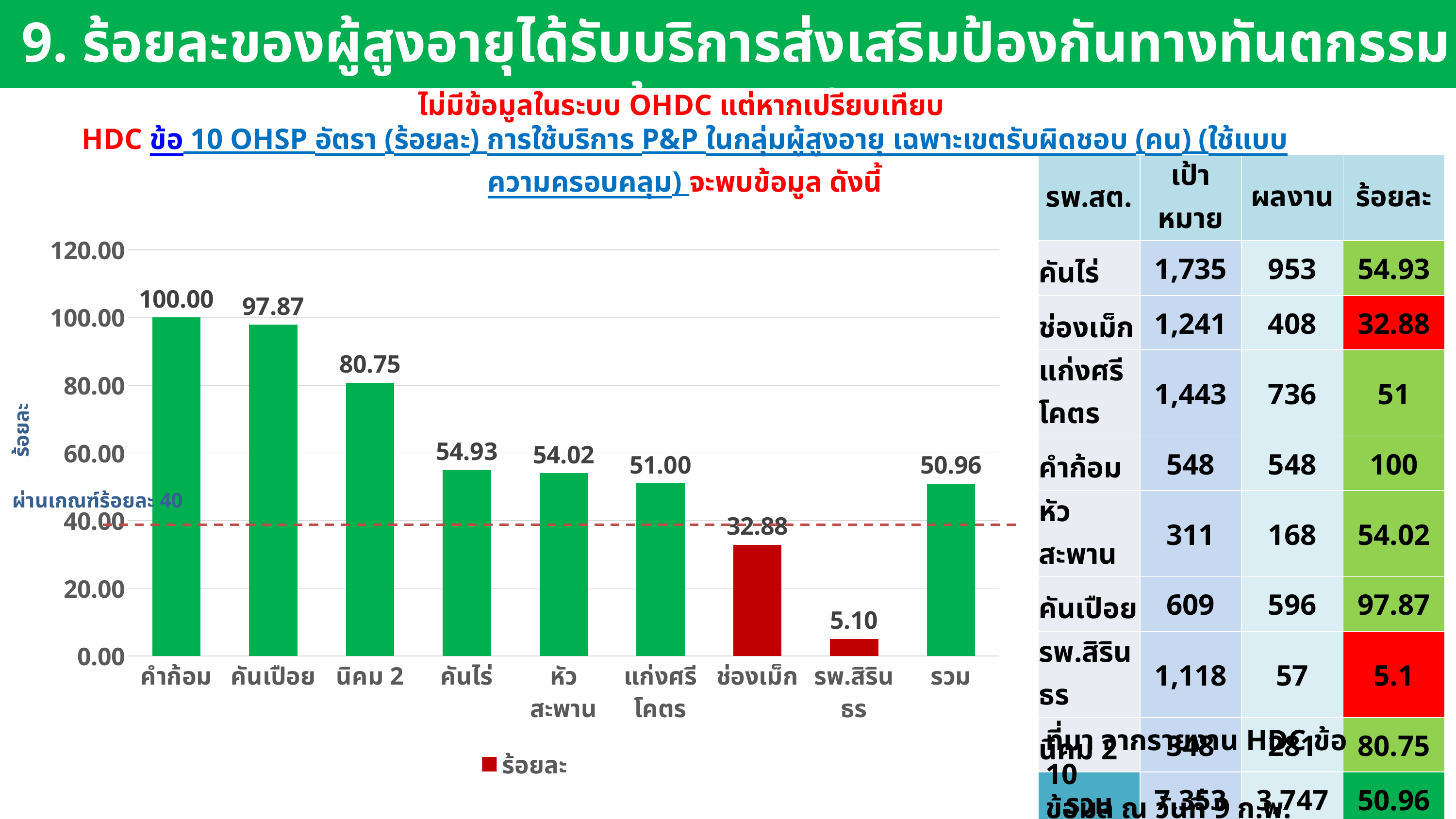
What kind of chart is shown? bar chart What is the legend entry for the series? ร้อยละ What is the value for ช่องเม็ก? 32.88 What is the difference between the values for คันเปือย and นิคม 2? 17.12 What is the value for คำก้อม? 100.00 How many series does the legend list? 1 Which category has the lowest value? รพ.สิรินธร Which category has the highest value? คำก้อม Which is larger, the value for คันไร่ or the value for แก่งศรีโคตร? คันไร่ What is the value for รวม? 50.96 How many categories are shown on the x axis? 9 Is the value for ช่องเม็ก greater or less than 40? less